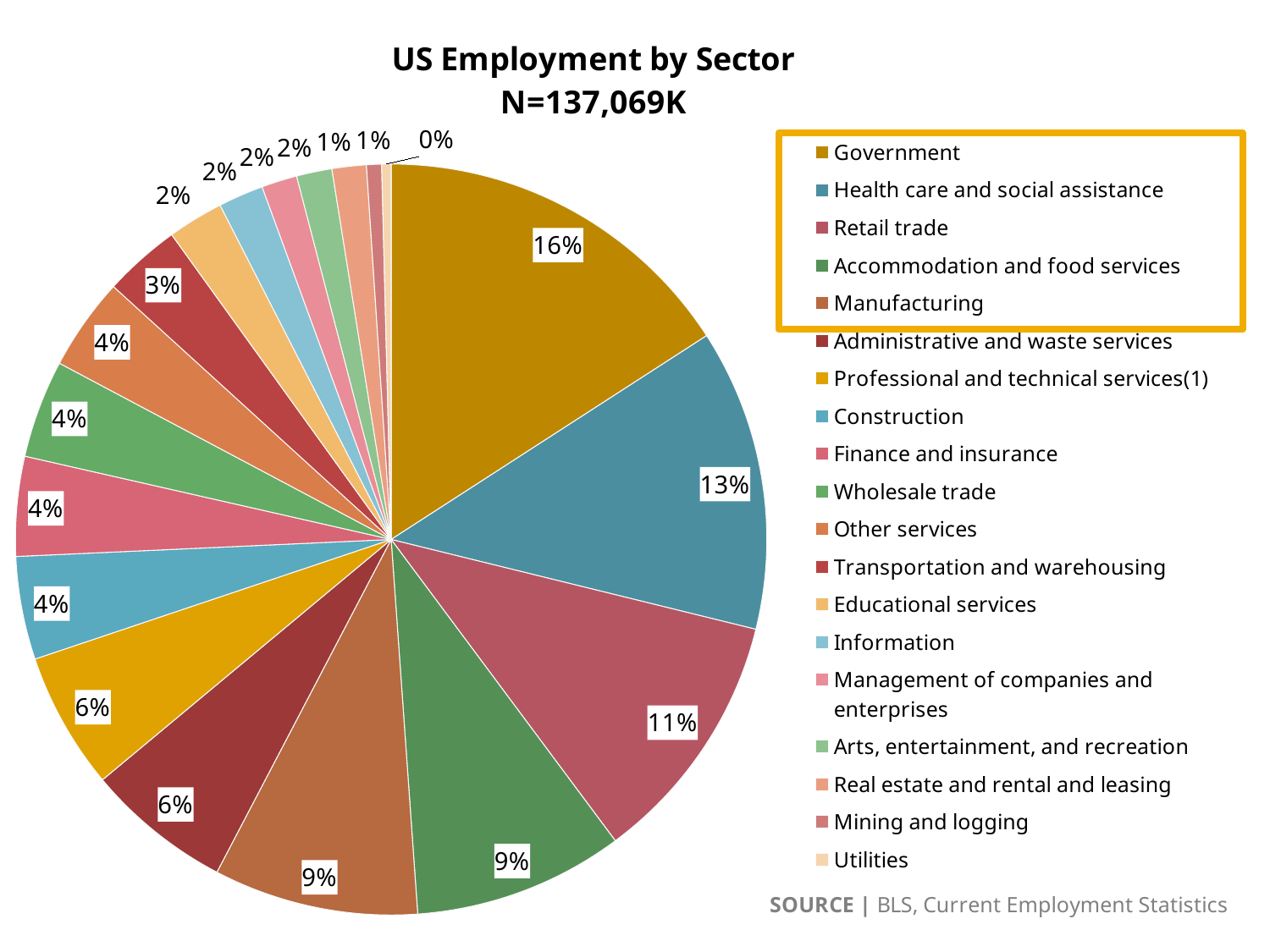
What total N is stated in the chart title? N=137,069K Which sector has the largest share of US employment? Government How many percentage points larger is the Government share than the Health care and social assistance share? 3 percentage points Which has a larger share, Retail trade or Manufacturing? Retail trade How many sectors are listed in the legend? 19 What percentage is shown for Transportation and warehousing? 3% What type of chart is used to show US Employment by Sector? Pie chart What percentage is shown for Health care and social assistance? 13% What percentage is shown for Retail trade? 11% What percentage is shown for Utilities? 0% What share of US employment does the Government sector account for? 16% Which sector has the smallest share of US employment? Utilities